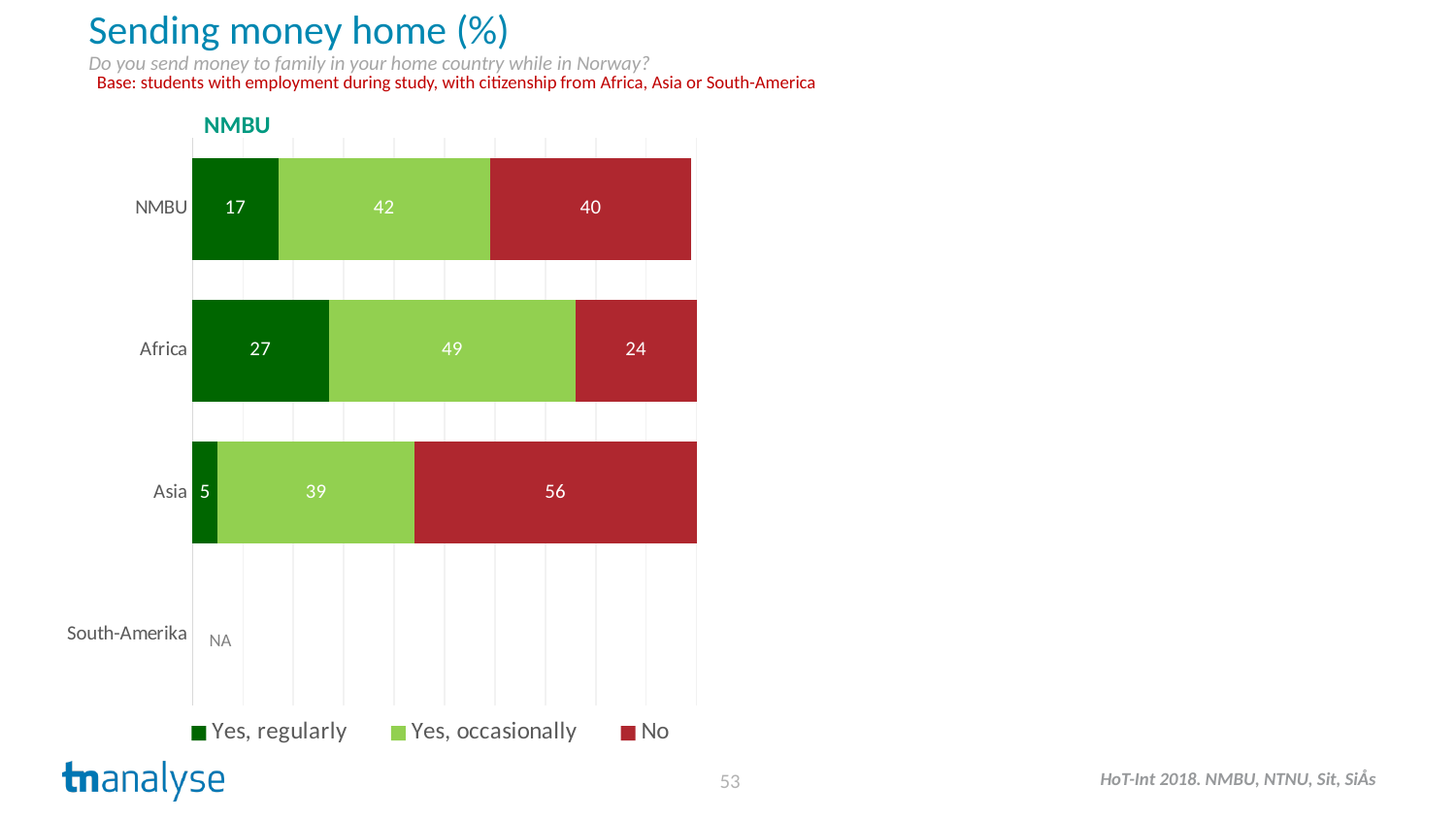
What is the total of the stacked bar for Africa? 100 What is the value for "Yes, occasionally" for Asia? 39 What percentage of NMBU students answered "No" to sending money home? 40 What is the difference between the "No" values for Asia and Africa? 32 What kind of chart is shown on the slide? Stacked bar chart Which is larger: "Yes, occasionally" for Africa or for NMBU? Africa What is the value for "Yes, regularly" for Africa? 27 Which category has the highest value for "No"? Asia What is shown for the South-Amerika category? NA Which category has the lowest value for "Yes, regularly"? Asia What is the title of the chart? NMBU How many series does the legend list? 3